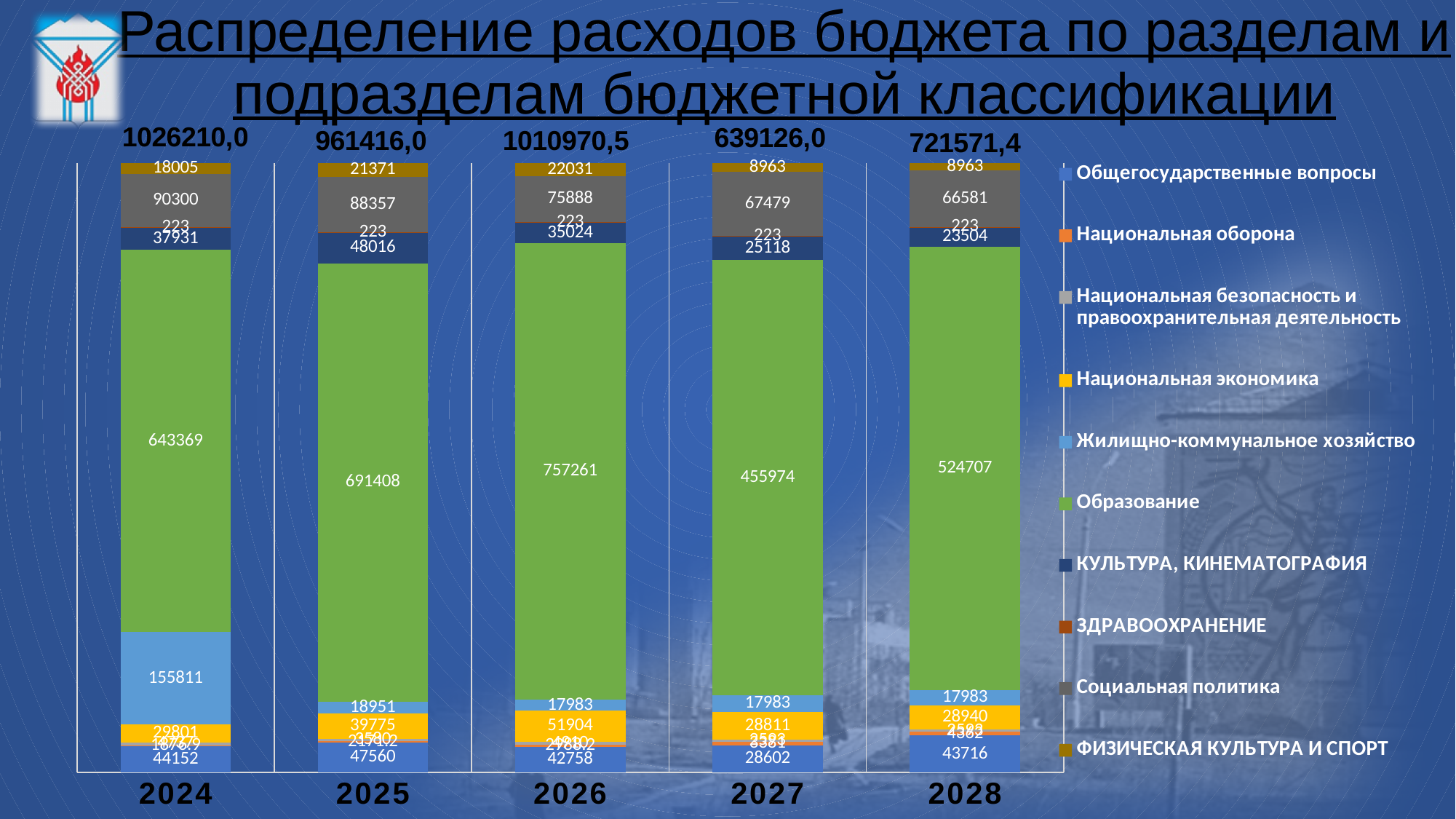
How many series does the legend list? 10 Which is larger: Социальная политика in 2025 or in 2028? 2025 What is the value for Социальная политика in 2024? 90300 Which year has the lowest total budget expenditure? 2027 What kind of chart is shown on the slide? stacked bar chart What is the value for Жилищно-коммунальное хозяйство in 2024? 155811 What is the difference between the Образование values for 2026 and 2027? 301287 Which year has the highest value for Образование? 2026 What is the total printed above the bar for 2027? 639126,0 What is the value for Образование in 2026? 757261 How many years (categories) are shown on the x axis? 5 What is the value for ФИЗИЧЕСКАЯ КУЛЬТУРА И СПОРТ in 2026? 22031